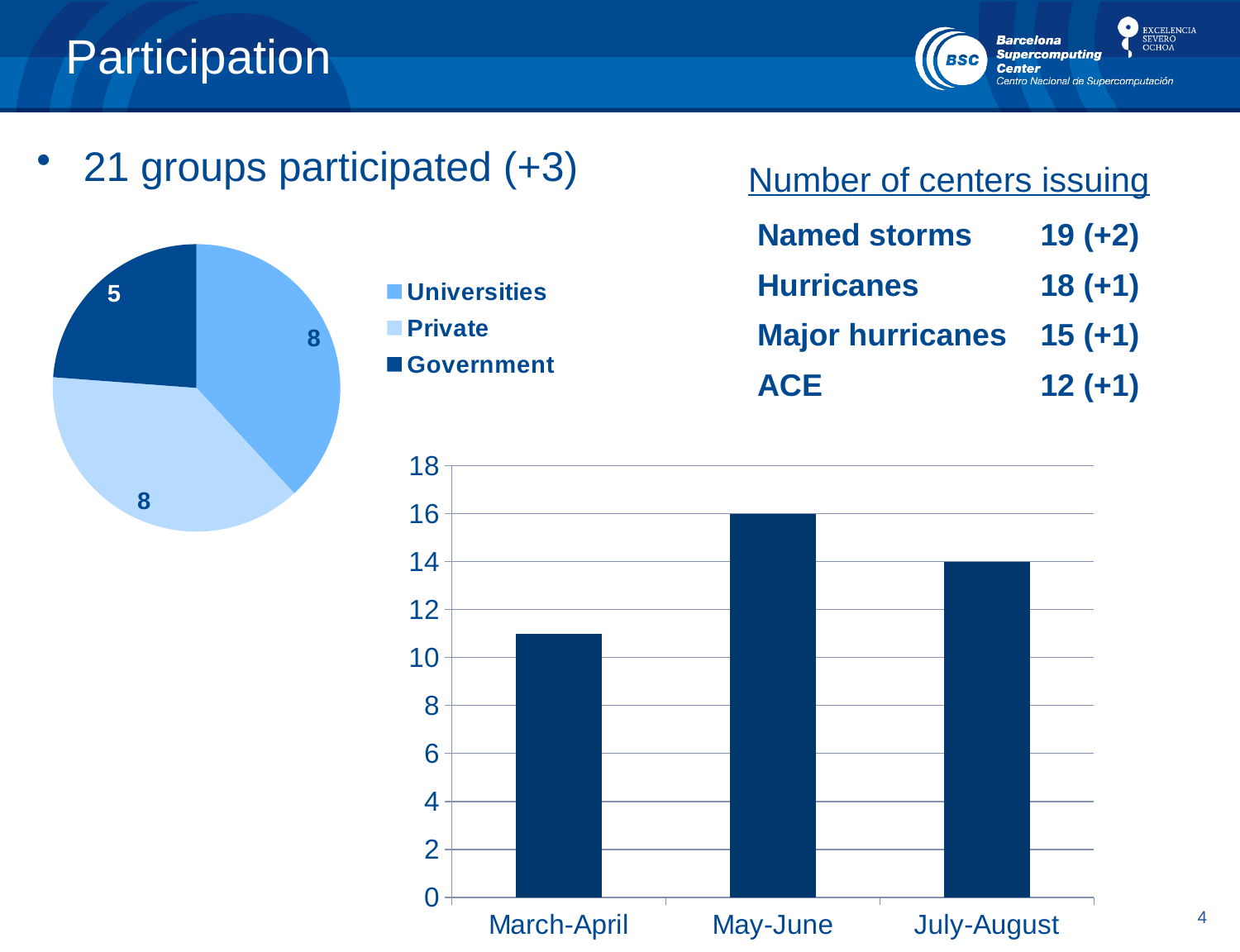
In the bar chart at the bottom of the slide, which period has the highest value? May-June What kind of chart is the chart at the bottom of the slide? Bar chart How many slices does the pie chart have? 3 In the bar chart at the bottom of the slide, what is the value for July-August? 14 In the pie chart, what is the value for Government? 5 In the bar chart at the bottom of the slide, what is the difference between the values for May-June and July-August? 2 In the bar chart at the bottom of the slide, which period has the lowest value? March-April In the bar chart at the bottom of the slide, what is the value for May-June? 16 In the bar chart at the bottom of the slide, is the value for March-April greater or less than 10? greater In the pie chart, which category has the smallest slice? Government What kind of chart is the chart on the left of the slide? Pie chart In the pie chart, what is the value for Universities? 8